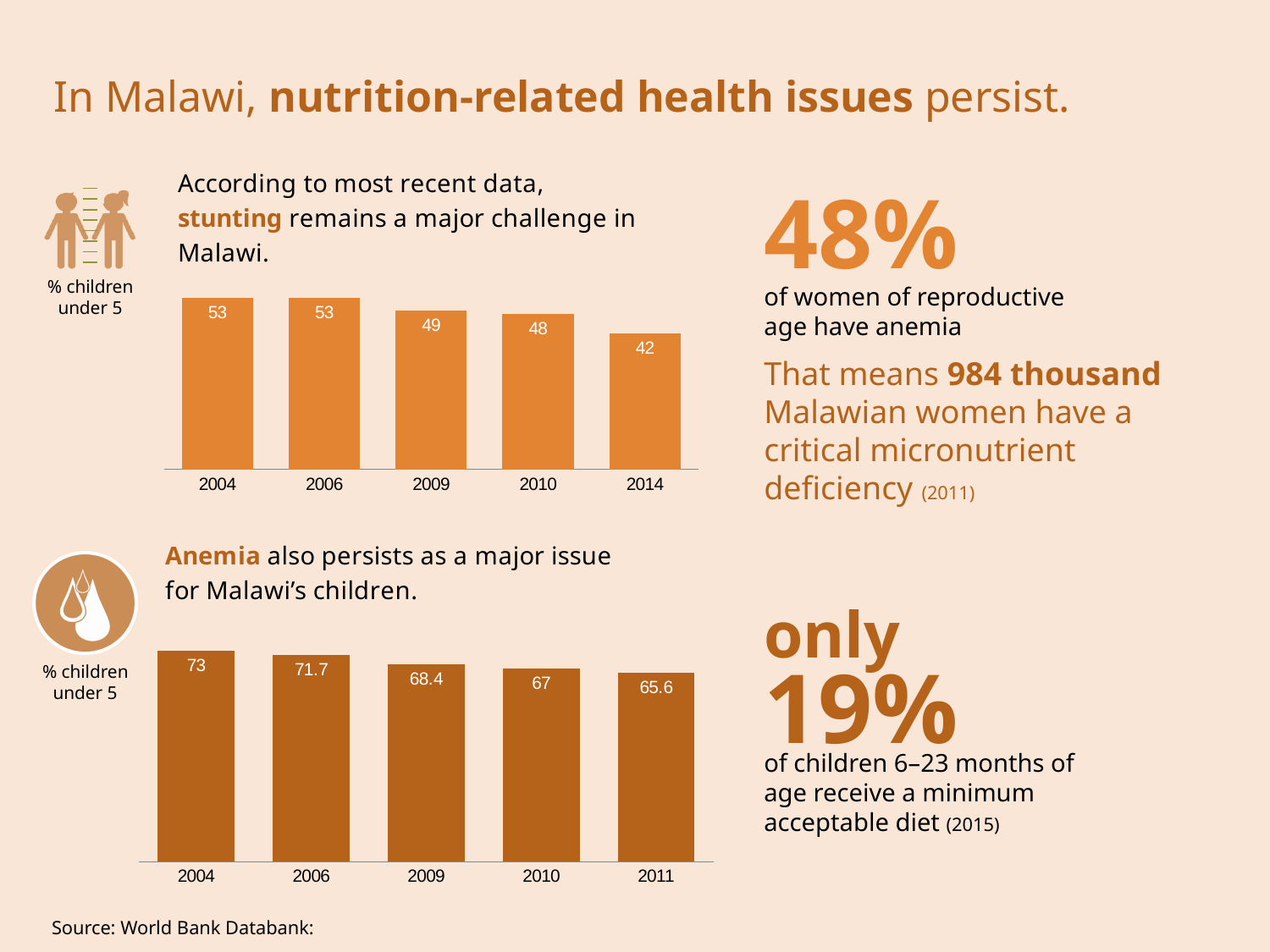
In the top chart on stunting, how many years are shown on the x axis? 5 In the bottom chart on anemia in children, is the value for 2009 larger or smaller than the value for 2010? larger In the top chart on stunting, which year has the lowest value? 2014 In the top chart on stunting, do the values rise or fall from 2004 to 2014? fall In the top chart on stunting, what is the difference between the 2004 value and the 2014 value? 11 In the top chart on stunting, what is the value for 2009? 49 In the bottom chart on anemia in children, which year has the highest value? 2004 In the bottom chart on anemia in children, what is the value for 2011? 65.6 What kind of chart is the bottom chart on anemia in children? bar chart In the bottom chart on anemia in children, what is the difference between the 2004 value and the 2011 value? 7.4 In the top chart on stunting, what is the value for 2014? 42 In the bottom chart on anemia in children, what is the value for 2006? 71.7